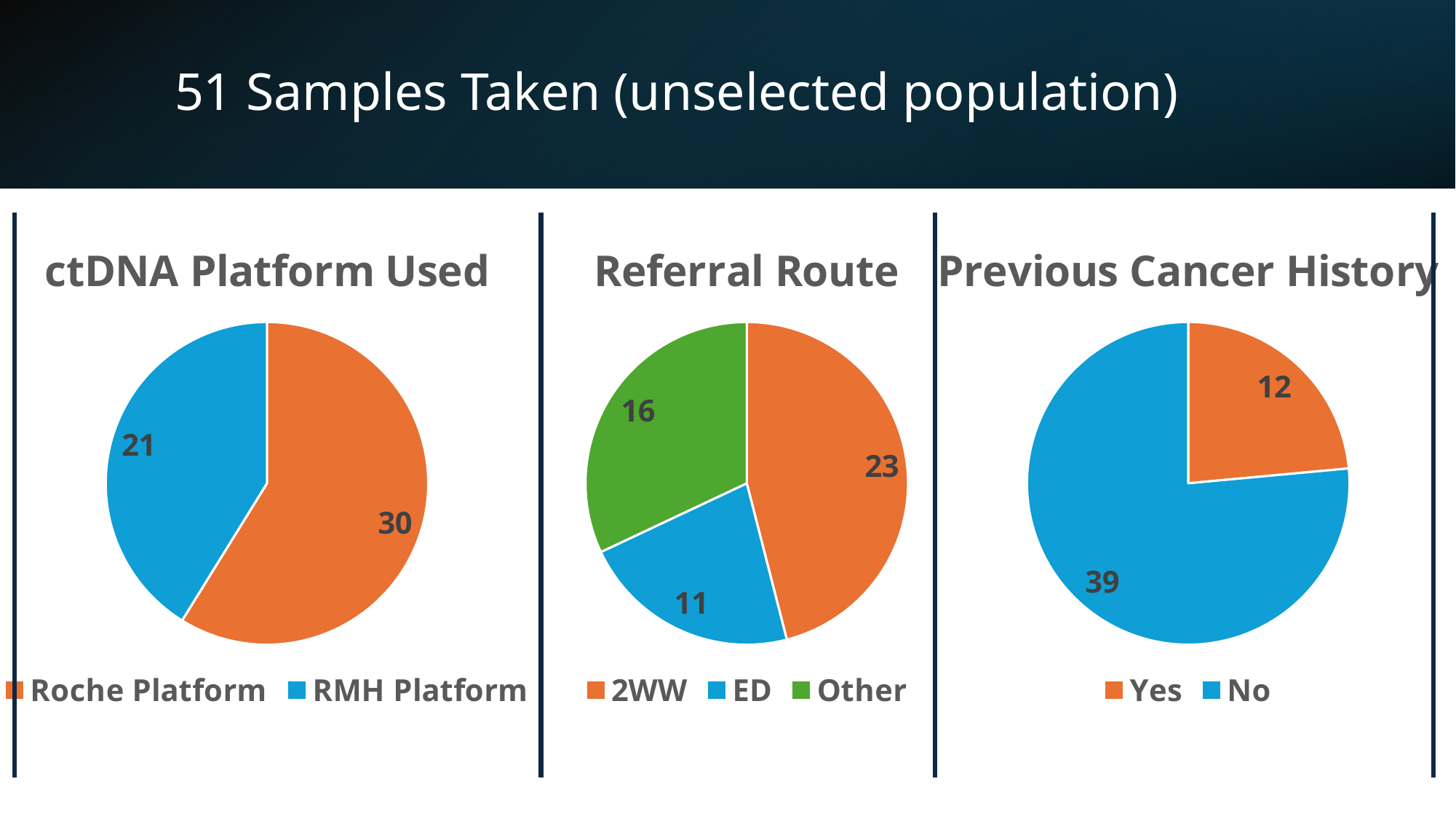
In the 'ctDNA Platform Used' chart, what colour is the RMH Platform slice? Blue In the 'Referral Route' chart, how many categories are shown? 3 What kind of chart is the 'Previous Cancer History' chart? Pie chart In the 'Referral Route' chart, which referral route has the lowest value? ED In the 'ctDNA Platform Used' chart, what is the value for Roche Platform? 30 In the 'ctDNA Platform Used' chart, what is the value for RMH Platform? 21 In the 'Previous Cancer History' chart, what is the value for Yes? 12 In the 'Referral Route' chart, what is the difference between the Other and ED values? 5 In the 'Referral Route' chart, which referral route has the highest value? 2WW In the 'Previous Cancer History' chart, which is larger, Yes or No? No In the 'ctDNA Platform Used' chart, what is the difference between the Roche Platform and RMH Platform values? 9 In the 'Referral Route' chart, what is the value for 2WW? 23